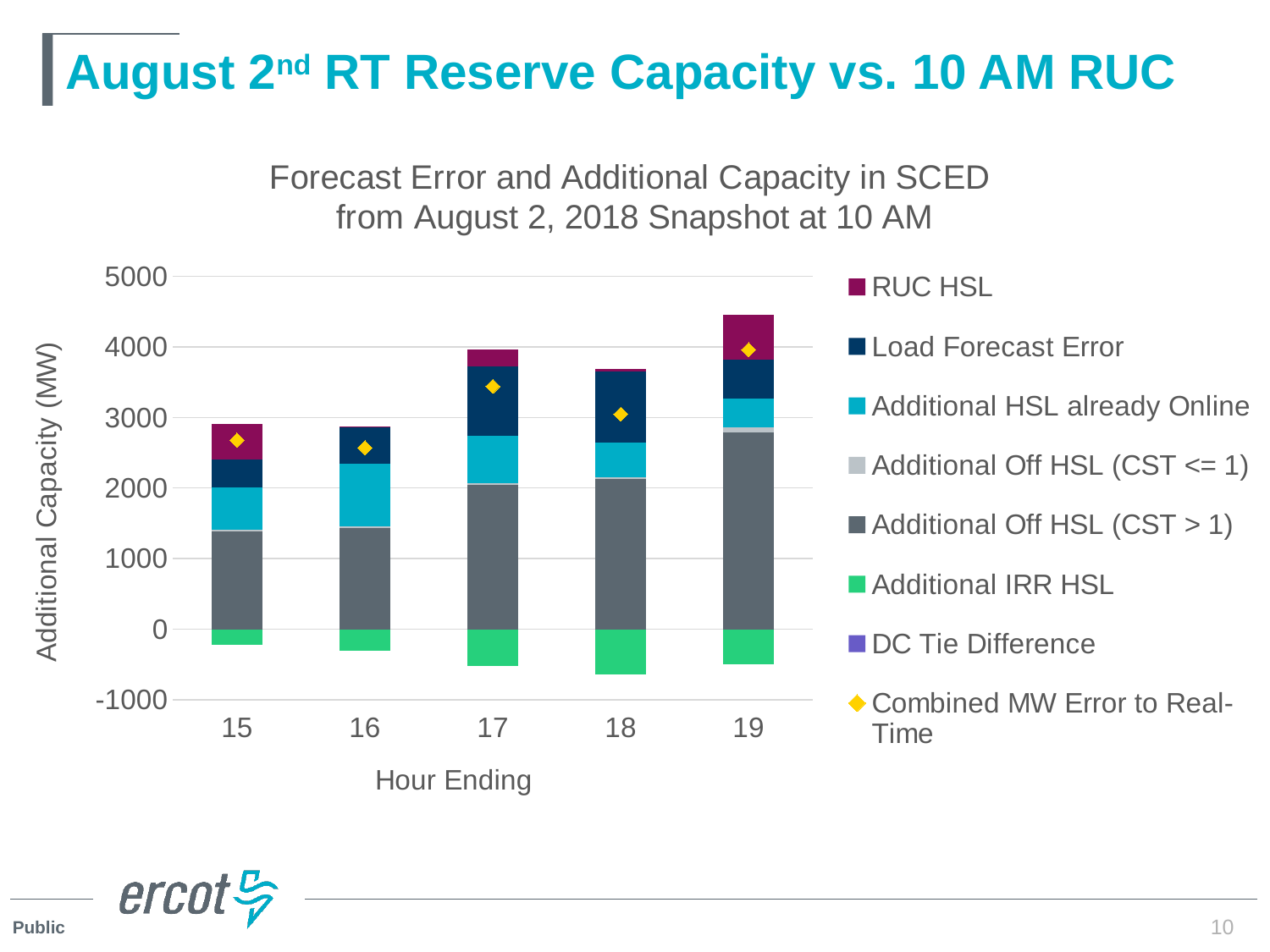
How many Hour Ending categories are shown on the x axis? 5 Is the Combined MW Error to Real-Time value for Hour Ending 15 greater or less than 2000? greater How many series does the legend list? 8 What kind of chart is shown on the slide? Stacked bar chart Is the top of the stacked bar for Hour Ending 15 greater or less than 3000? less Which has the larger Combined MW Error to Real-Time value, Hour Ending 17 or Hour Ending 15? Hour Ending 17 Is the top of the stacked bar for Hour Ending 19 greater or less than 4000? greater What is the label of the y axis? Additional Capacity (MW) Which Hour Ending has the tallest stacked bar above zero? 19 What is the title of the chart? Forecast Error and Additional Capacity in SCED from August 2, 2018 Snapshot at 10 AM